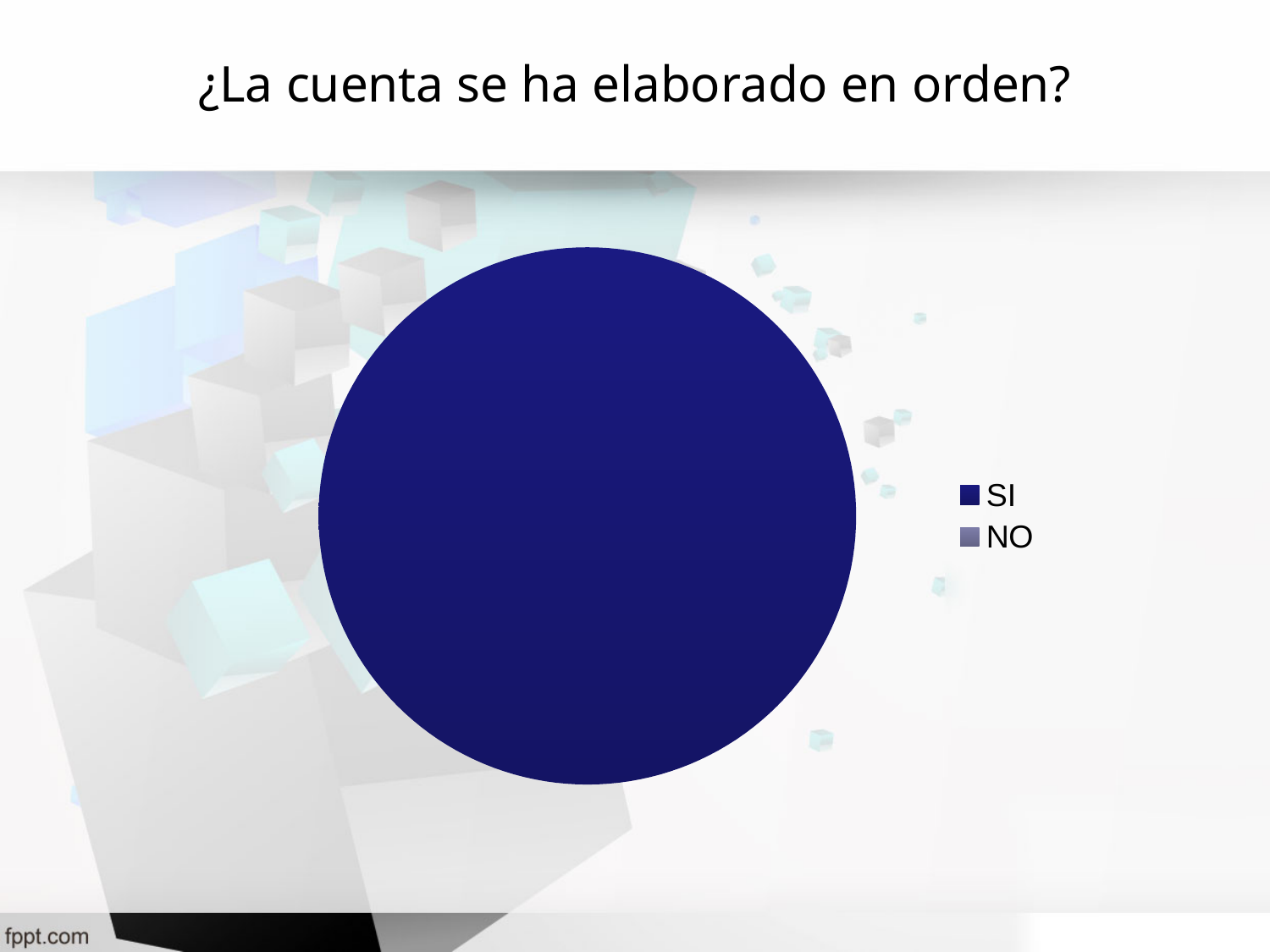
What kind of chart is shown on the slide? pie chart What is the title of the slide containing the pie chart? ¿La cuenta se ha elaborado en orden? How many entries does the legend of the pie chart list? 2 What colour represents SI in the pie chart legend? dark blue Which category takes up the largest share of the pie chart? SI Which category has the smallest share of the pie chart? NO Which is larger in the pie chart, SI or NO? SI